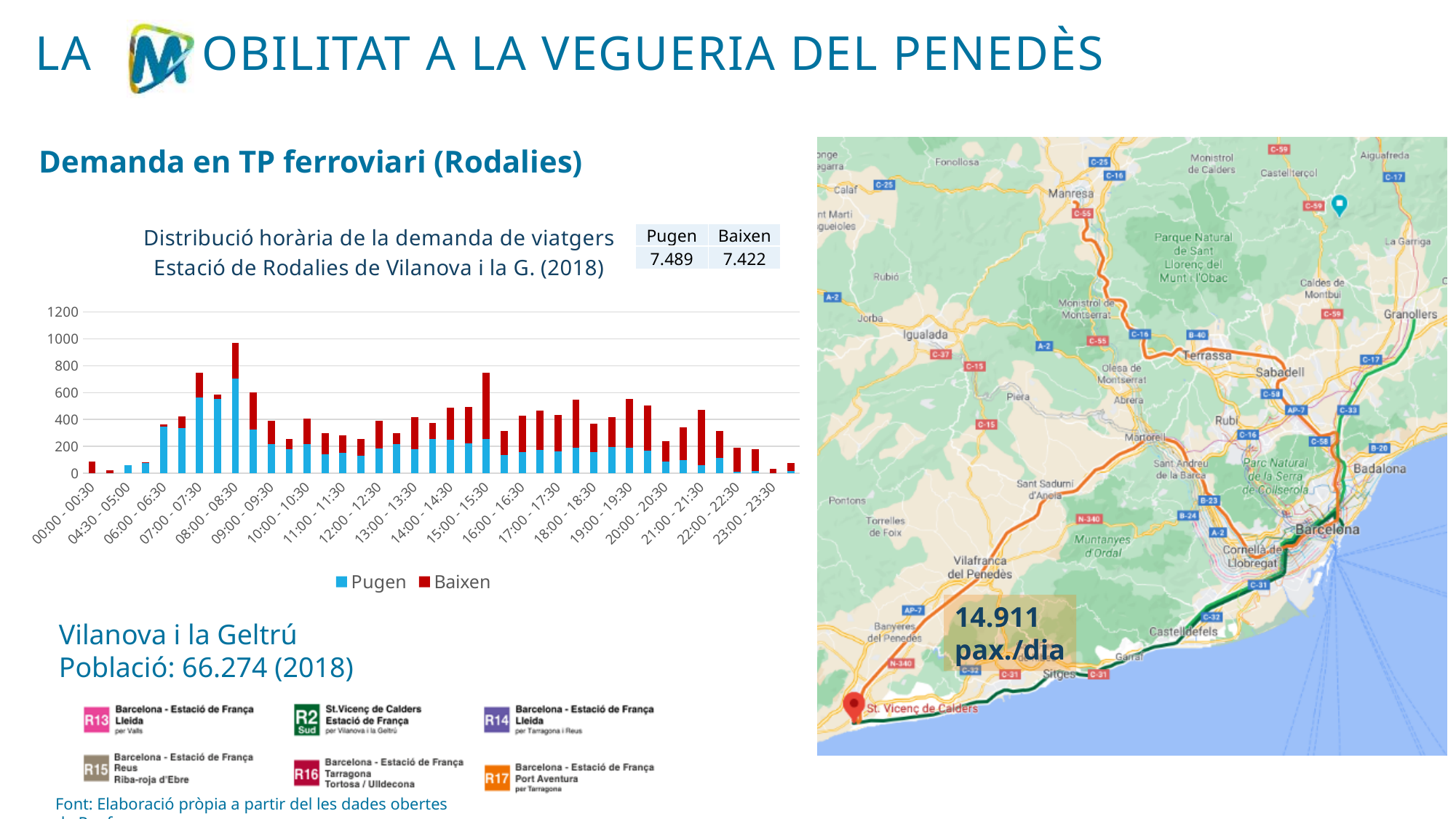
What are the two series named in the legend of the hourly demand chart? Pugen and Baixen According to the table next to the chart title, what is the total value for Baixen? 7.422 Which labelled time slot has the tallest stacked bar in the hourly demand chart? 08:00 - 08:30 Which total is larger in the table next to the chart title, Pugen or Baixen? Pugen Is the total height of the stacked bar for 08:00 - 08:30 greater or less than 800? greater How many series does the legend of the hourly demand chart list? 2 Is the total height of the stacked bar for 00:00 - 00:30 greater or less than 200? less Which colour represents the Pugen series in the hourly demand chart? Blue In the 08:00 - 08:30 bar, which series is larger, Pugen or Baixen? Pugen What kind of chart is used to show the hourly distribution of passenger demand at the Vilanova i la Geltrú Rodalies station? bar chart According to the table next to the chart title, what is the total value for Pugen? 7.489 What is the difference between the Pugen total (7.489) and the Baixen total (7.422) shown in the table? 67